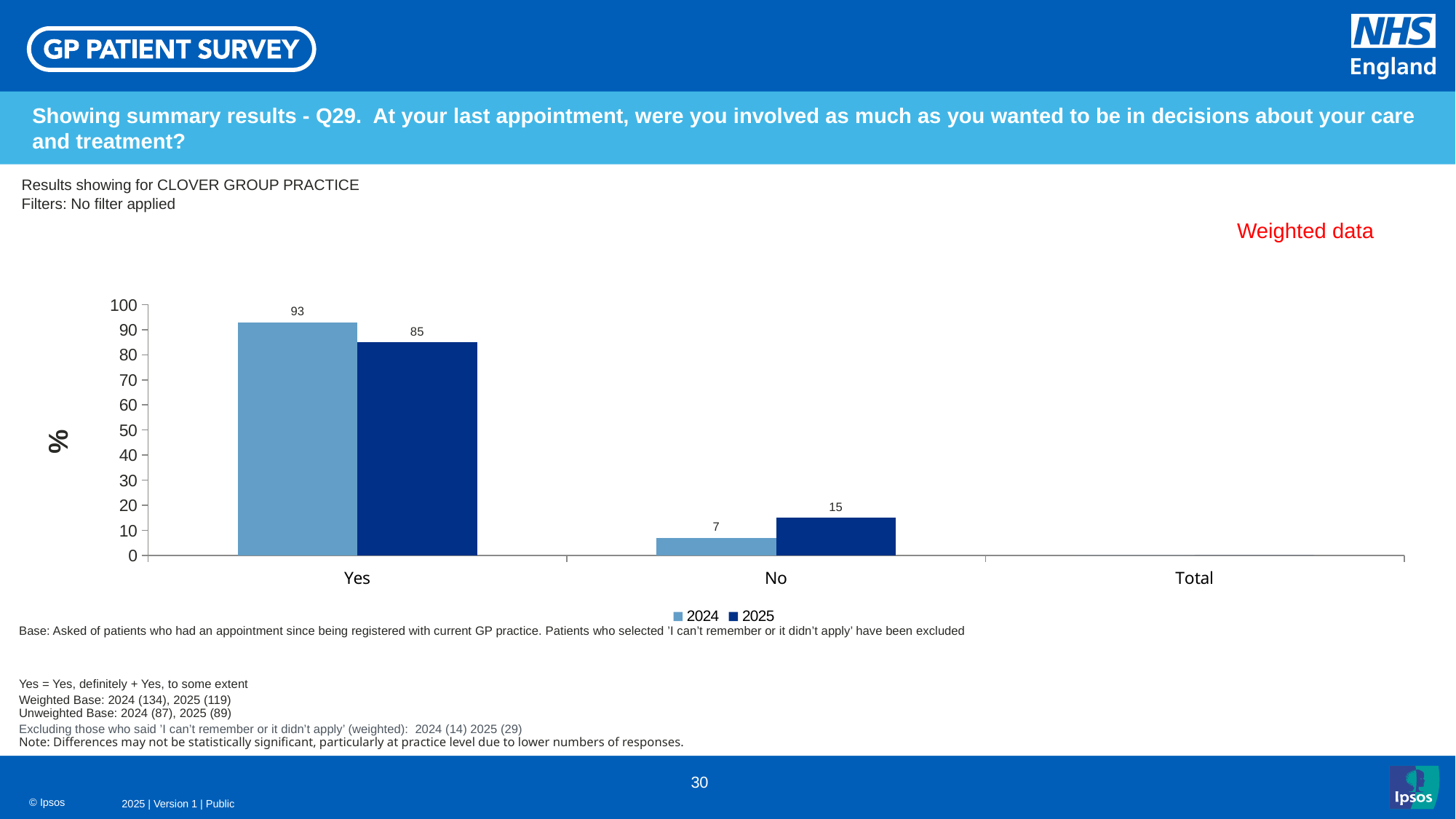
What is the difference between the 2025 and 2024 values for No? 8 What kind of chart is shown on the slide? Bar chart What is the value for No in 2025? 15 Which is larger for No: the 2024 value or the 2025 value? 2025 What is the value for Yes in 2025? 85 What is the value for No in 2024? 7 What is the value for Yes in 2024? 93 What is the difference between the 2024 and 2025 values for Yes? 8 Which category has the highest value in the 2025 series? Yes How many series does the legend list? 2 Which category has the lowest value in the 2024 series? No What label is shown on the vertical axis? %